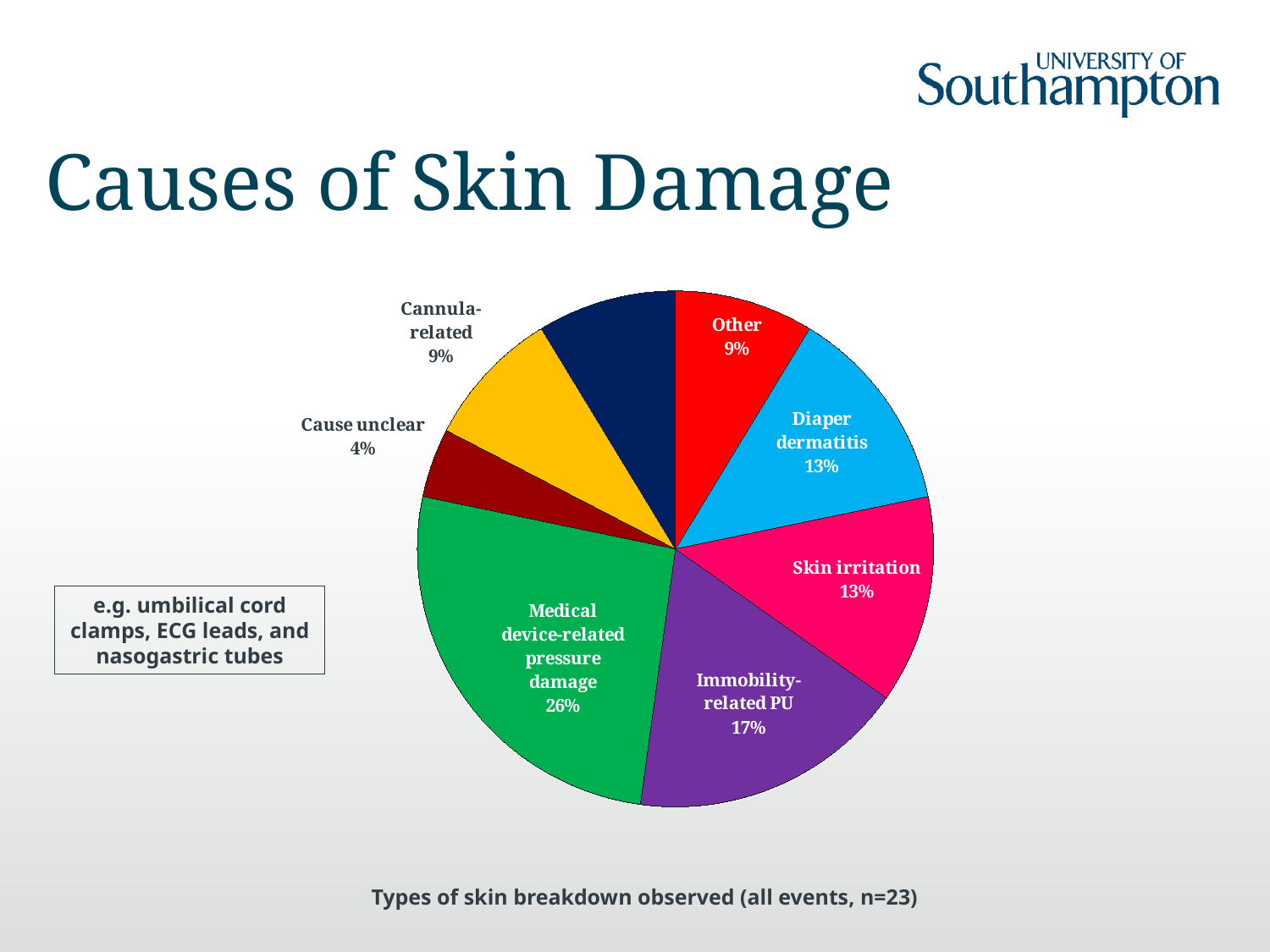
What is the value shown for Cause unclear? 4% Which labelled cause has the largest share of the pie? Medical device-related pressure damage What is the value shown for Immobility-related PU? 17% What percentage of the pie is Medical device-related pressure damage? 26% Which is larger, the share for Immobility-related PU or the share for Skin irritation? Immobility-related PU Which labelled cause has the smallest share of the pie? Cause unclear What is the difference in percentage points between Medical device-related pressure damage and Immobility-related PU? 9 percentage points How many slices does the pie chart have? 8 What is the value shown for Cannula-related? 9% What is the value shown for Diaper dermatitis? 13% What is the caption printed below the pie chart? Types of skin breakdown observed (all events, n=23) What kind of chart is shown on the slide? pie chart